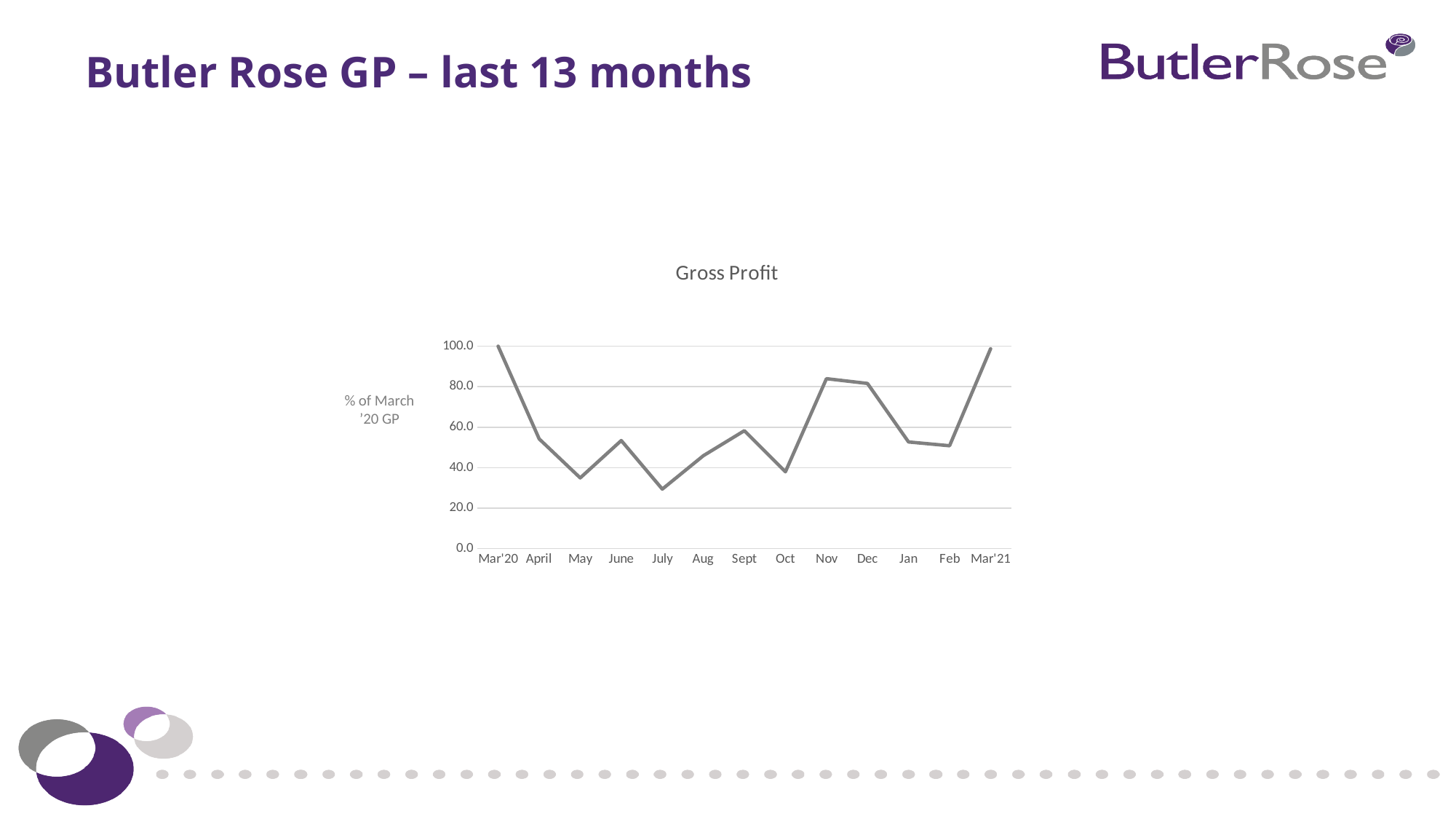
Which is larger, the value for Nov or the value for Oct? Nov Which is larger, the value for Sept or the value for July? Sept Is the value for July greater or less than 40.0? less What is the title of the chart on the slide? Gross Profit Is the value for April greater or less than 60.0? less How many months are plotted on the x axis of the Gross Profit chart? 13 What kind of chart is shown on the slide? line chart Does the value rise or fall from Mar'20 to April? fall Is the value for Nov greater or less than 80.0? greater What is the value for Mar'20 in the Gross Profit chart? 100.0 Which month has the lowest value in the Gross Profit chart? July